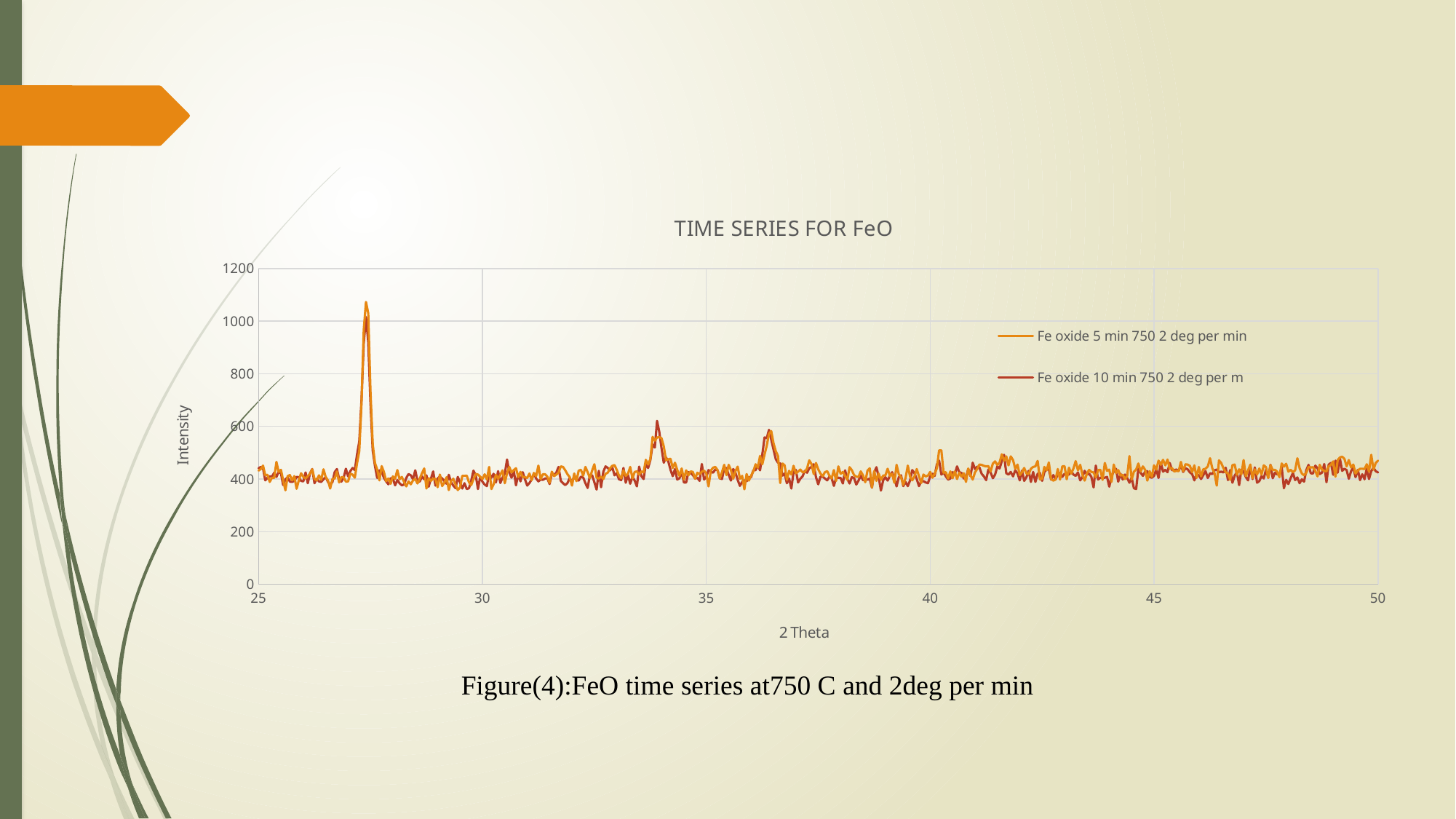
Is the highest peak of the Fe oxide 5 min 750 2 deg per min series greater or less than 1200? less Is the peak of the Fe oxide 10 min 750 2 deg per m series near 2 Theta = 34 greater or less than 800? less How many series does the chart legend list? 2 What is the label of the x axis? 2 Theta What is the maximum value shown on the Intensity axis? 1200 Is the baseline intensity of both series between 2 Theta = 45 and 50 greater or less than 200? greater What is the title of the chart? TIME SERIES FOR FeO What kind of chart is shown on the slide? line chart Which series has the tallest peak near 2 Theta = 27, Fe oxide 5 min 750 2 deg per min or Fe oxide 10 min 750 2 deg per m? Fe oxide 5 min 750 2 deg per min